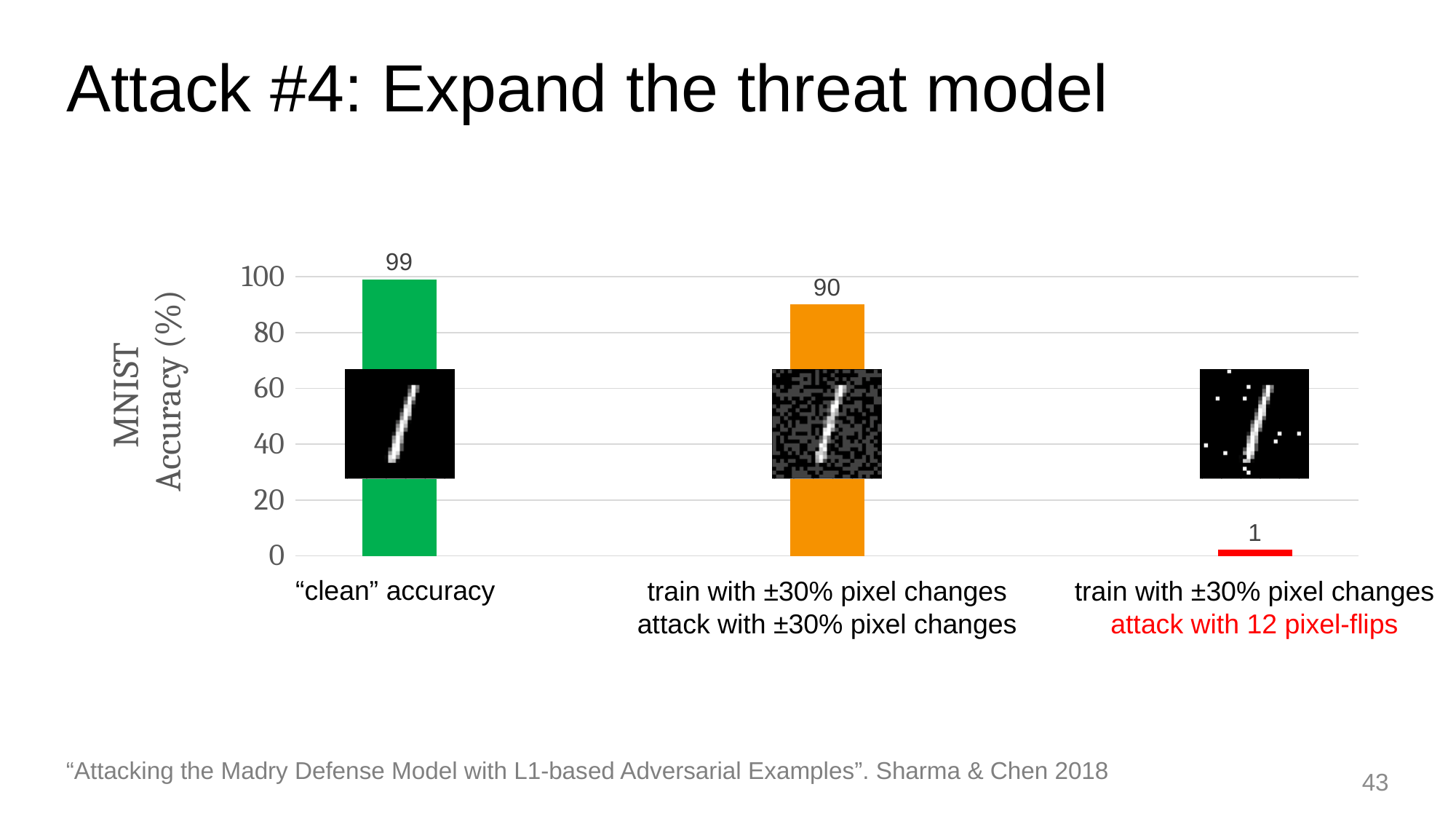
Is the accuracy under the 12 pixel-flips attack greater or less than 20? less What is the label of the vertical axis? MNIST Accuracy (%) Which category has the highest MNIST accuracy? "clean" accuracy What is the MNIST accuracy when training with ±30% pixel changes and attacking with 12 pixel-flips? 1 What is the difference in accuracy between the ±30% pixel changes attack and the 12 pixel-flips attack? 89 How many categories are shown in the chart? 3 What kind of chart is shown on the slide? bar chart Which category has the lowest MNIST accuracy? train with ±30% pixel changes, attack with 12 pixel-flips What is the MNIST accuracy when training with ±30% pixel changes and attacking with ±30% pixel changes? 90 What is the difference in accuracy between "clean" accuracy and the ±30% pixel changes attack? 9 Which is larger: the accuracy under the ±30% pixel changes attack or under the 12 pixel-flips attack? ±30% pixel changes attack What is the MNIST accuracy for "clean" accuracy? 99